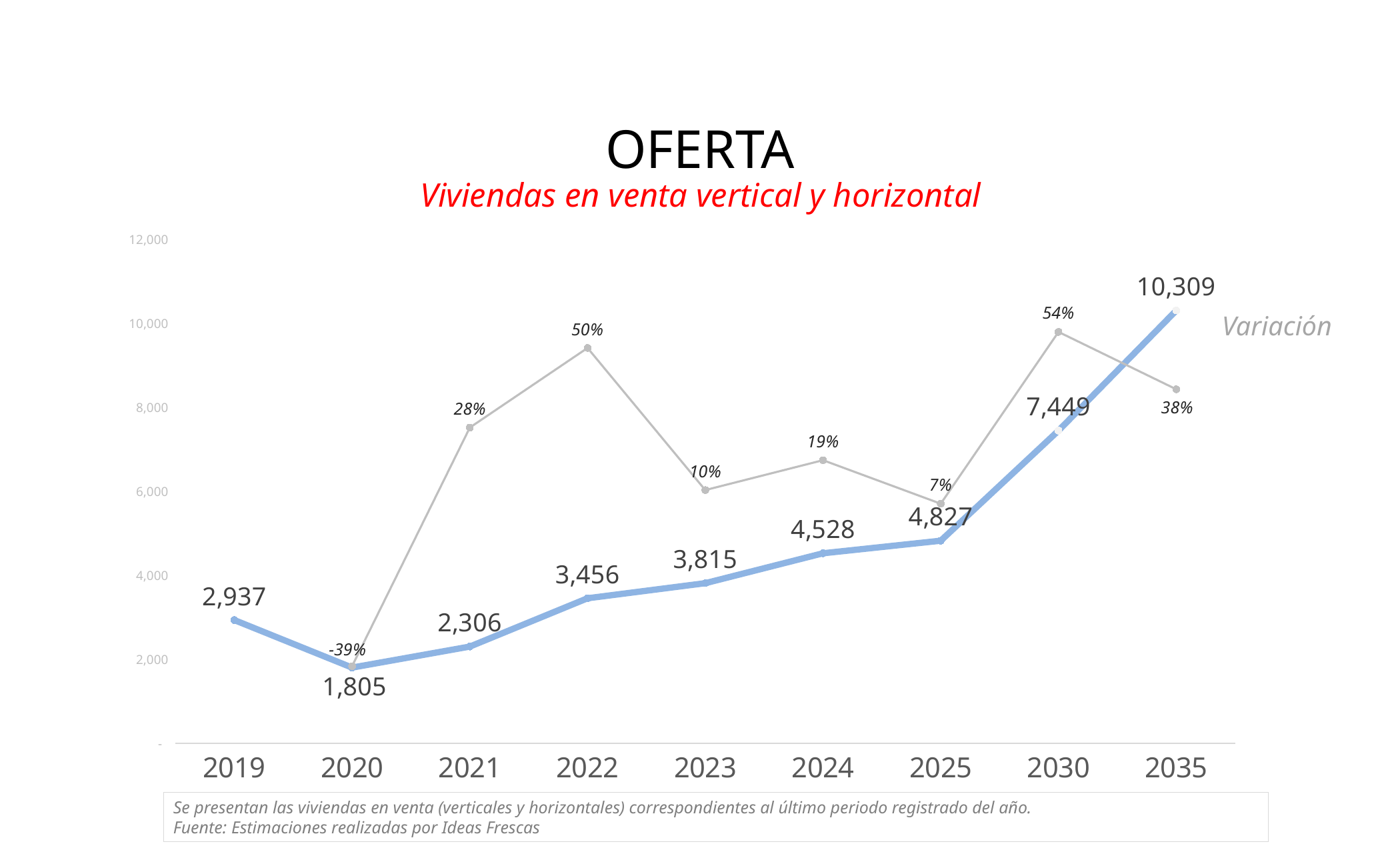
What is the Variación percentage shown for 2022? 50% Which year has the lowest number of viviendas en venta? 2020 Do the viviendas en venta values rise or fall from 2020 to 2035? Rise What kind of chart is shown on the slide? Line chart What is the number of viviendas en venta for 2025? 4,827 What is the Variación percentage shown for 2020? -39% What is the number of viviendas en venta for 2019? 2,937 How many years are shown on the x axis? 9 What is the difference in viviendas en venta between 2035 and 2030? 2,860 What is the red subtitle of the chart? Viviendas en venta vertical y horizontal Which year has the highest number of viviendas en venta? 2035 Which year has more viviendas en venta, 2021 or 2023? 2023